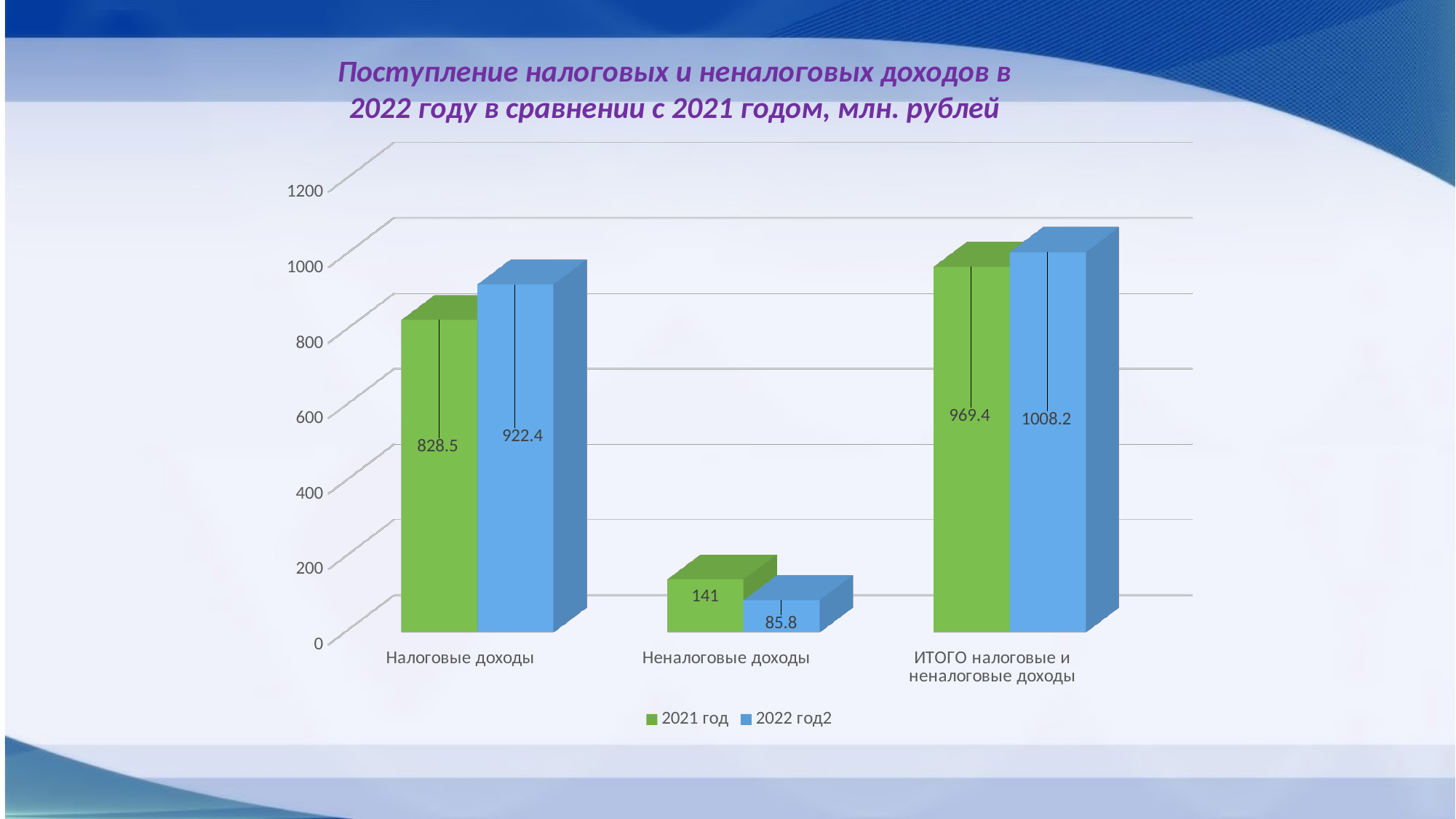
What is the difference between the 2022 год2 and 2021 год values for Налоговые доходы? 93.9 For Неналоговые доходы, which series has the larger value, 2021 год or 2022 год2? 2021 год Which category has the lowest value in the 2022 год2 series? Неналоговые доходы What is the value for Неналоговые доходы in the 2021 год series? 141 What is the value for Налоговые доходы in the 2021 год series? 828.5 How many series does the legend list? 2 What is the value for Неналоговые доходы in the 2022 год2 series? 85.8 How many categories are shown on the x axis? 3 What is the value for Налоговые доходы in the 2022 год2 series? 922.4 Which category has the highest value in the 2021 год series? ИТОГО налоговые и неналоговые доходы What kind of chart is shown on the slide? Bar chart What is the value for ИТОГО налоговые и неналоговые доходы in the 2022 год2 series? 1008.2